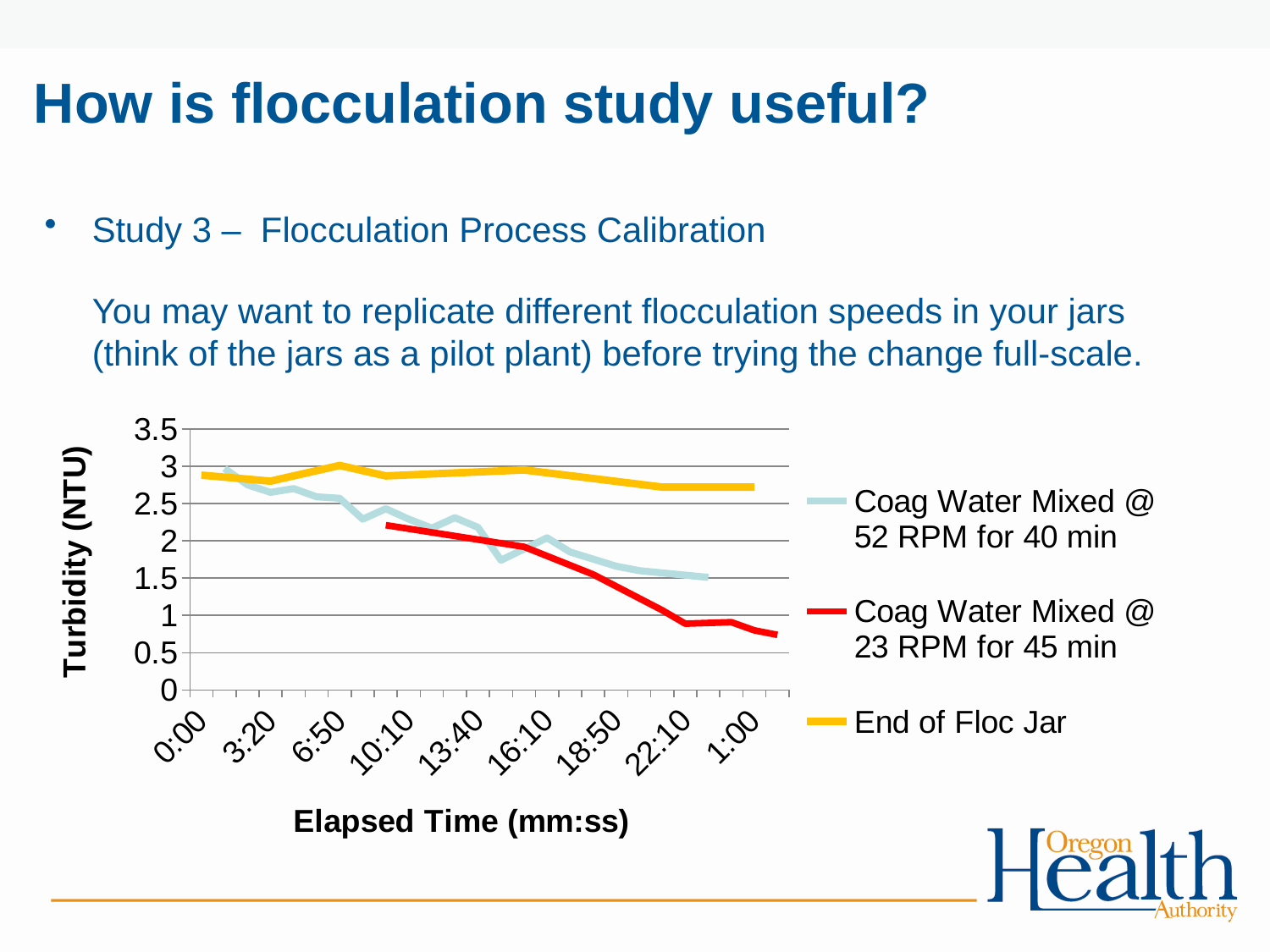
What is the title of the vertical axis? Turbidity (NTU) At 18:50, which series has the higher turbidity: 'Coag Water Mixed @ 52 RPM for 40 min' or 'Coag Water Mixed @ 23 RPM for 45 min'? Coag Water Mixed @ 52 RPM for 40 min At 1:00, which series has the higher turbidity: 'End of Floc Jar' or 'Coag Water Mixed @ 23 RPM for 45 min'? End of Floc Jar Which series has the highest turbidity at 22:10? End of Floc Jar What kind of chart is shown on the slide? line chart How many series does the legend list? 3 Does the turbidity for 'Coag Water Mixed @ 23 RPM for 45 min' rise or fall as elapsed time increases? fall How many labelled tick marks are shown on the Elapsed Time axis? 9 Does the turbidity for 'Coag Water Mixed @ 52 RPM for 40 min' rise or fall as elapsed time increases? fall Is the turbidity for 'Coag Water Mixed @ 23 RPM for 45 min' at 1:00 greater or less than 1? less Is the turbidity for 'End of Floc Jar' at 0:00 greater or less than 2.5? greater